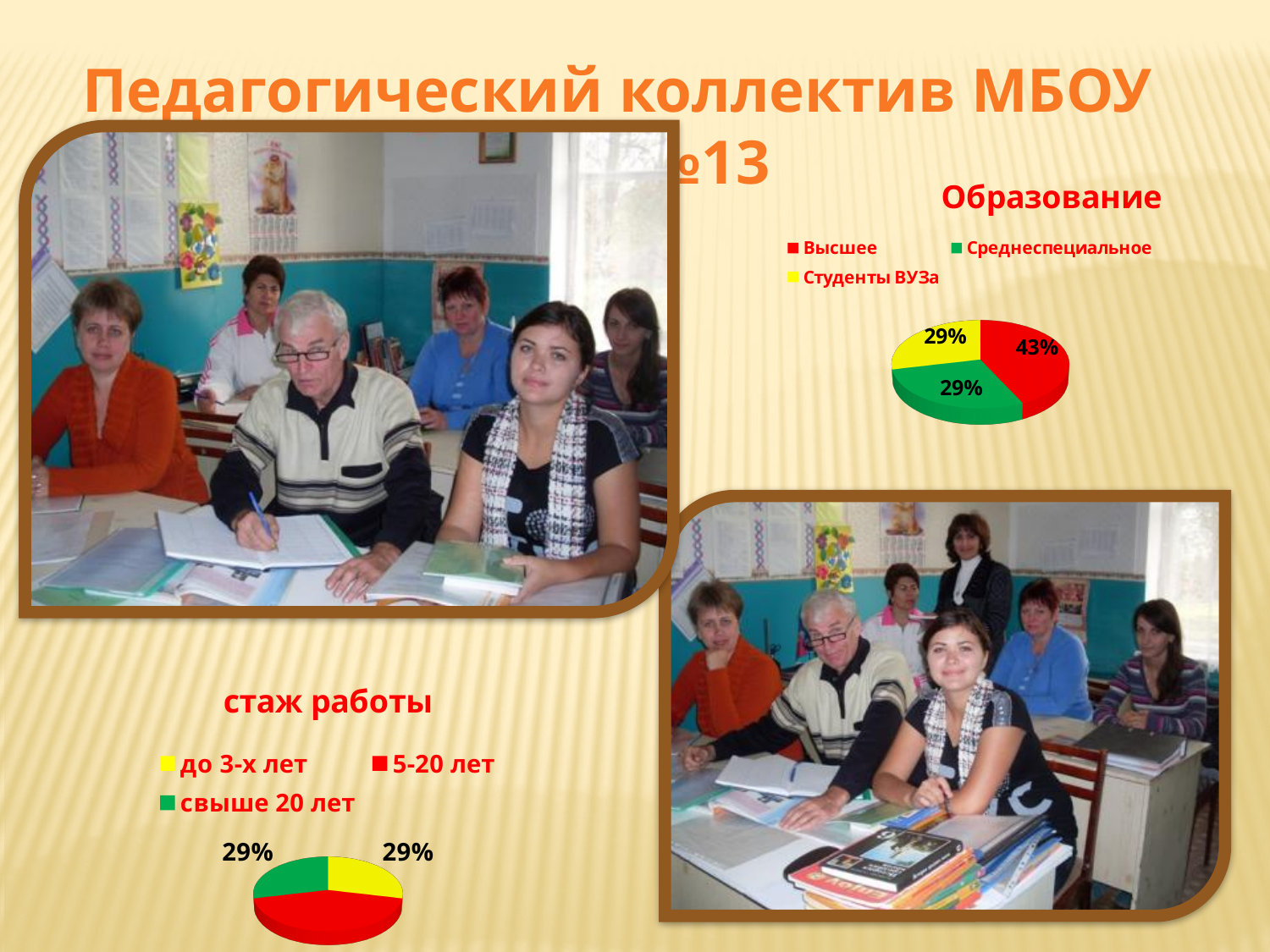
In the 'Образование' chart, what percentage is shown for Среднеспециальное? 29% In the 'Образование' chart, which colour represents Высшее? red In the 'стаж работы' chart, what percentage is shown for до 3-х лет? 29% In the 'Образование' chart, what is the difference between the shares of Высшее and Среднеспециальное? 14% In the 'стаж работы' chart, how many categories does the legend list? 3 In the 'Образование' chart, what percentage is shown for Высшее? 43% In the 'Образование' chart, how many categories does the legend list? 3 In the 'Образование' chart, which category has the largest share? Высшее In the 'стаж работы' chart, what percentage is shown for свыше 20 лет? 29% In the 'Образование' chart, what percentage is shown for Студенты ВУЗа? 29% In the 'стаж работы' chart, which category has the largest slice? 5-20 лет What type of chart is the 'Образование' chart? pie chart